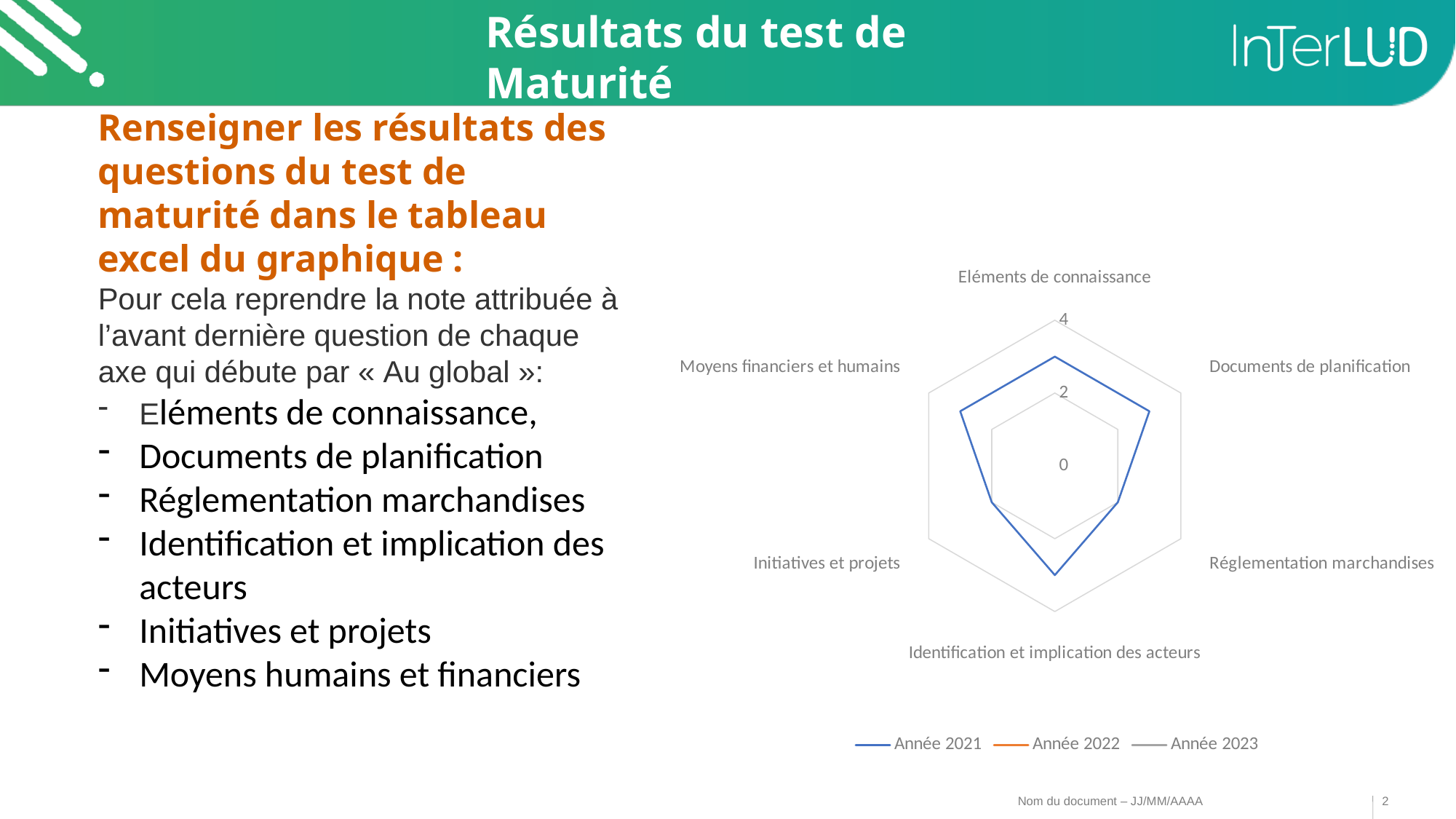
How many axes (categories) does the radar chart have? 6 Which series are listed in the chart legend? Année 2021, Année 2022, Année 2023 What kind of chart is shown on the slide? Radar chart Is the Année 2021 value for Eléments de connaissance greater or less than 4? less How many series does the chart legend list? 3 Is the Année 2021 value for Réglementation marchandises greater or less than 4? less Is the Année 2021 value for Eléments de connaissance greater or less than 2? greater For Année 2021, which is larger: the value for Eléments de connaissance or the value for Réglementation marchandises? Eléments de connaissance What colour is the line for Année 2021 in the chart? Blue